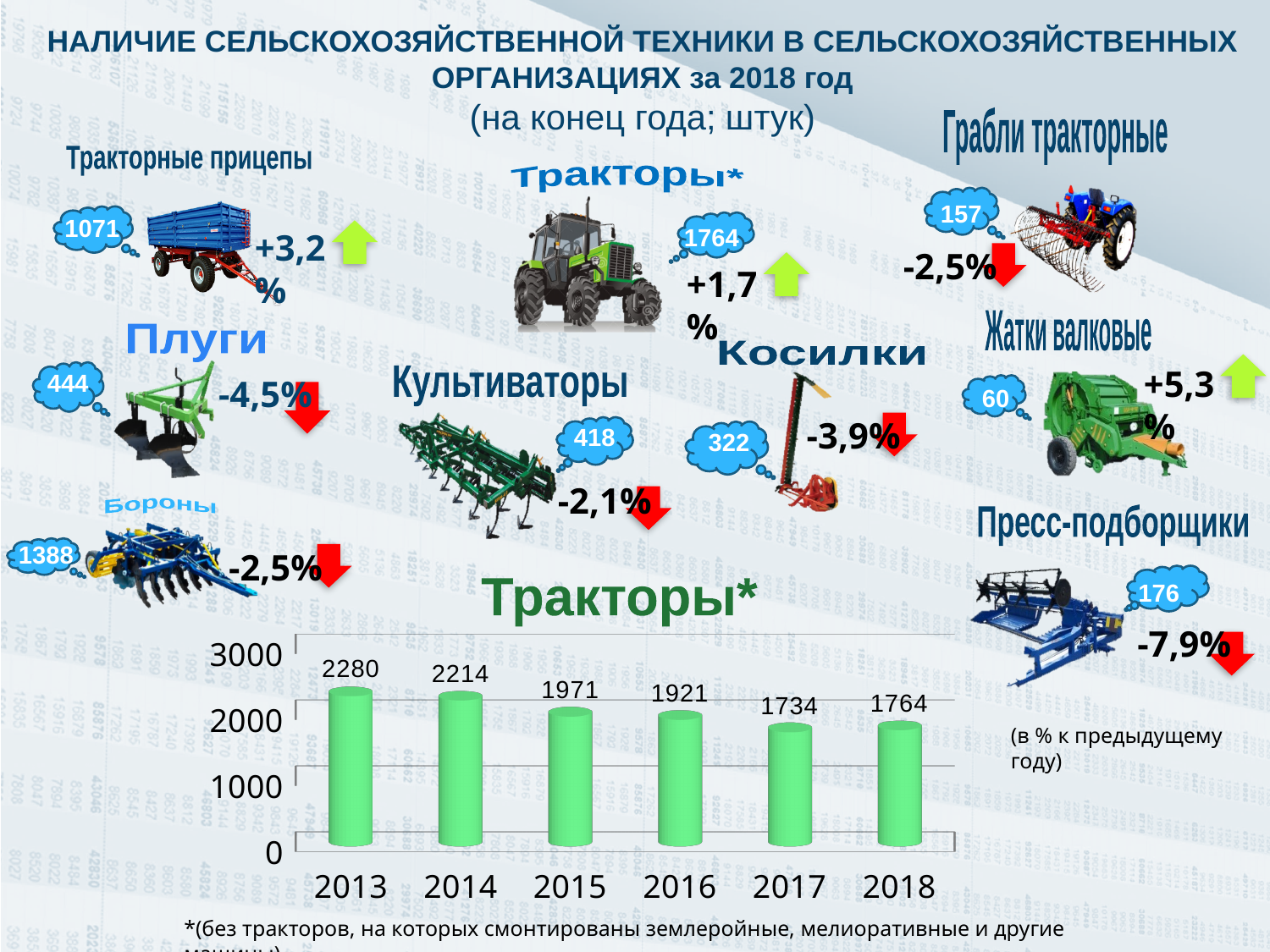
What is the difference between the values for 2013 and 2018 in the Тракторы* chart? 516 Which year has the highest value in the Тракторы* chart? 2013 What kind of chart is the Тракторы* chart? bar chart What is the value for 2018 in the Тракторы* chart? 1764 How many years are shown on the x axis of the Тракторы* chart? 6 Do the values in the Тракторы* chart generally rise or fall from 2013 to 2017? fall What is the value for 2013 in the Тракторы* chart? 2280 What is the difference between the values for 2015 and 2016 in the Тракторы* chart? 50 In the Тракторы* chart, which is larger: the value for 2014 or the value for 2015? 2014 What is the value for 2017 in the Тракторы* chart? 1734 Which year has the lowest value in the Тракторы* chart? 2017 Is the value for 2016 in the Тракторы* chart greater or less than 2000? less